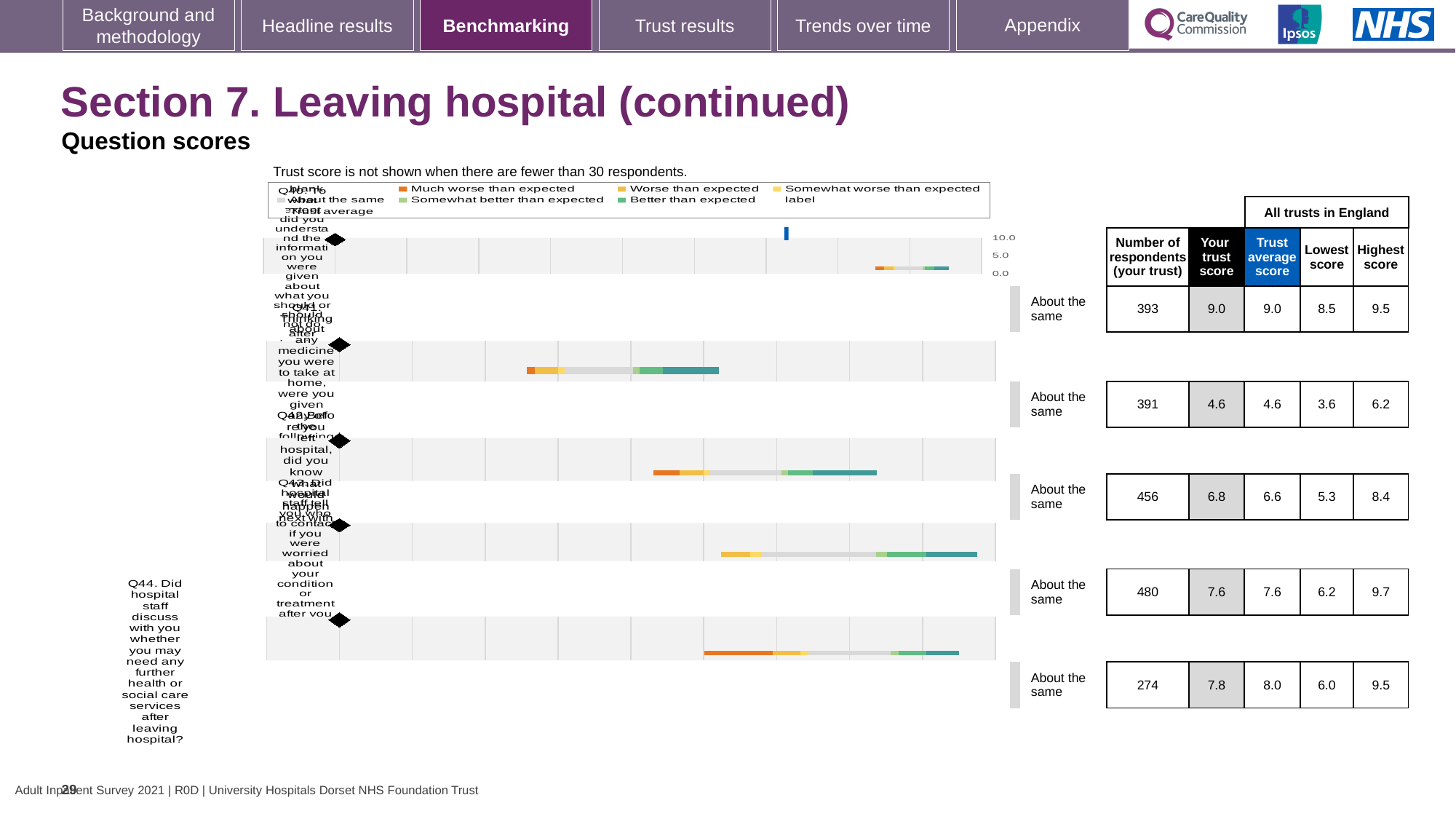
How many question rows are shown on the slide? 5 What is the trust score for Q44 (Did hospital staff discuss with you whether you may need any further health or care services after leaving hospital?)? 7.8 How many respondents from the trust answered Q44? 274 What is the trust average score across all trusts in England for Q44? 8.0 What is the difference between the highest score (9.5) and the lowest score (6.0) for Q44? 3.5 What is the lowest score among all trusts in England for Q44? 6.0 What is the minimum number of respondents required for a trust score to be shown? 30 What is the highest score among all trusts in England for Q44? 9.5 Which question row on the slide has the lowest 'Your trust score'? The second row (4.6) What benchmark category is shown for every question on this slide? About the same For the third question row, is the trust score (6.8) higher or lower than the trust average score (6.6)? Higher Which question row on the slide has the highest 'Your trust score'? The first row (9.0)